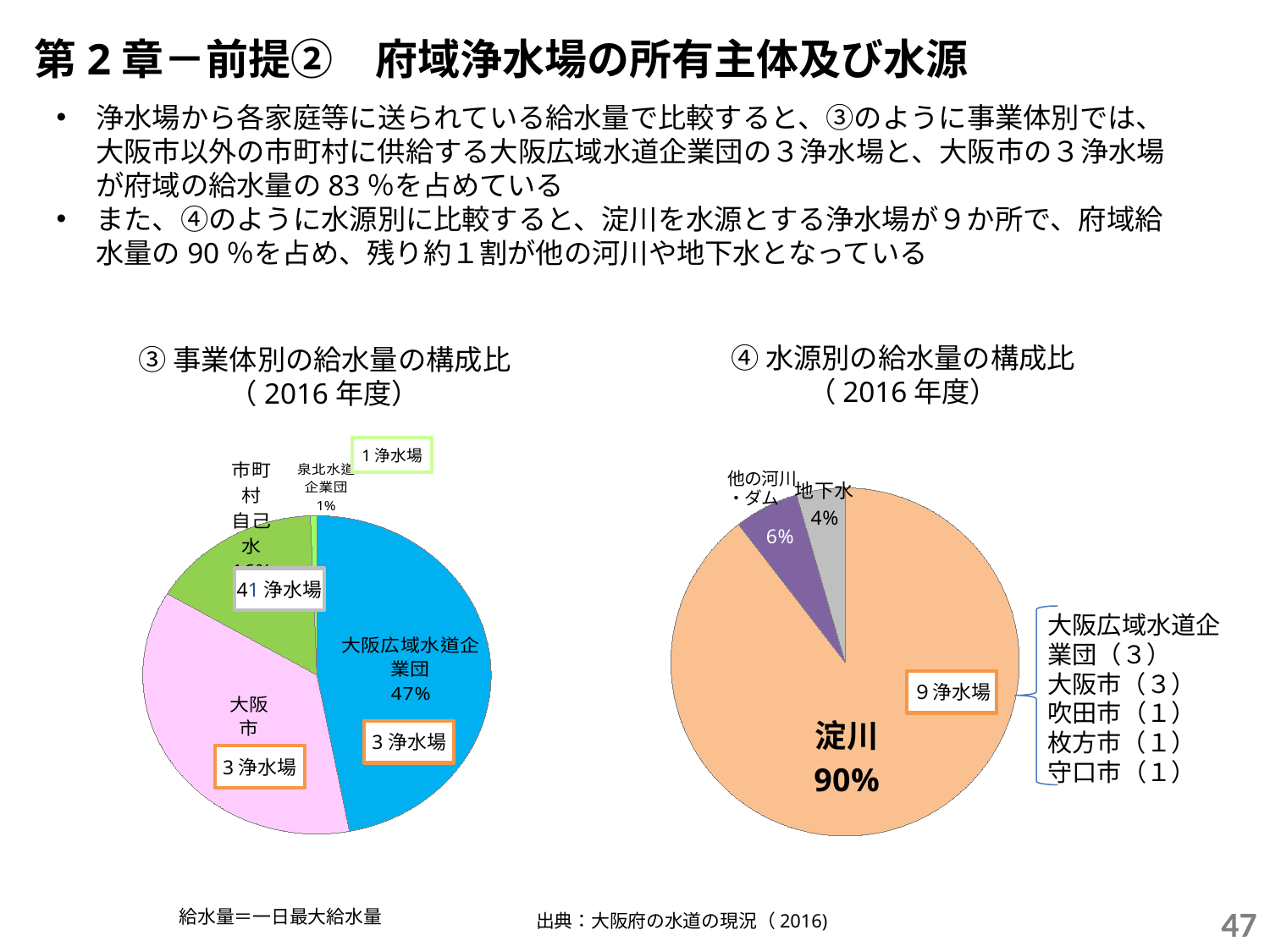
In the chart ④ 水源別の給水量の構成比 (2016年度), what is the difference in percentage points between 淀川 and 他の河川・ダム? 84% In the chart ④ 水源別の給水量の構成比 (2016年度), what share does 淀川 have? 90% In the chart ③ 事業体別の給水量の構成比 (2016年度), what share does 泉北水道企業団 have? 1% In the chart ③ 事業体別の給水量の構成比 (2016年度), which category has the largest share? 大阪広域水道企業団 In the chart ④ 水源別の給水量の構成比 (2016年度), which water source has the smallest share? 地下水 In the chart ④ 水源別の給水量の構成比 (2016年度), what share does 地下水 have? 4% In the chart ④ 水源別の給水量の構成比 (2016年度), which is larger, 他の河川・ダム or 地下水? 他の河川・ダム In the chart ③ 事業体別の給水量の構成比 (2016年度), what share does 大阪広域水道企業団 have? 47% How many slices does the chart ④ 水源別の給水量の構成比 (2016年度) have? 3 In the chart ③ 事業体別の給水量の構成比 (2016年度), which category has the smallest share? 泉北水道企業団 What type of chart is ③ 事業体別の給水量の構成比 (2016年度)? Pie chart In the chart ④ 水源別の給水量の構成比 (2016年度), what share does 他の河川・ダム have? 6%